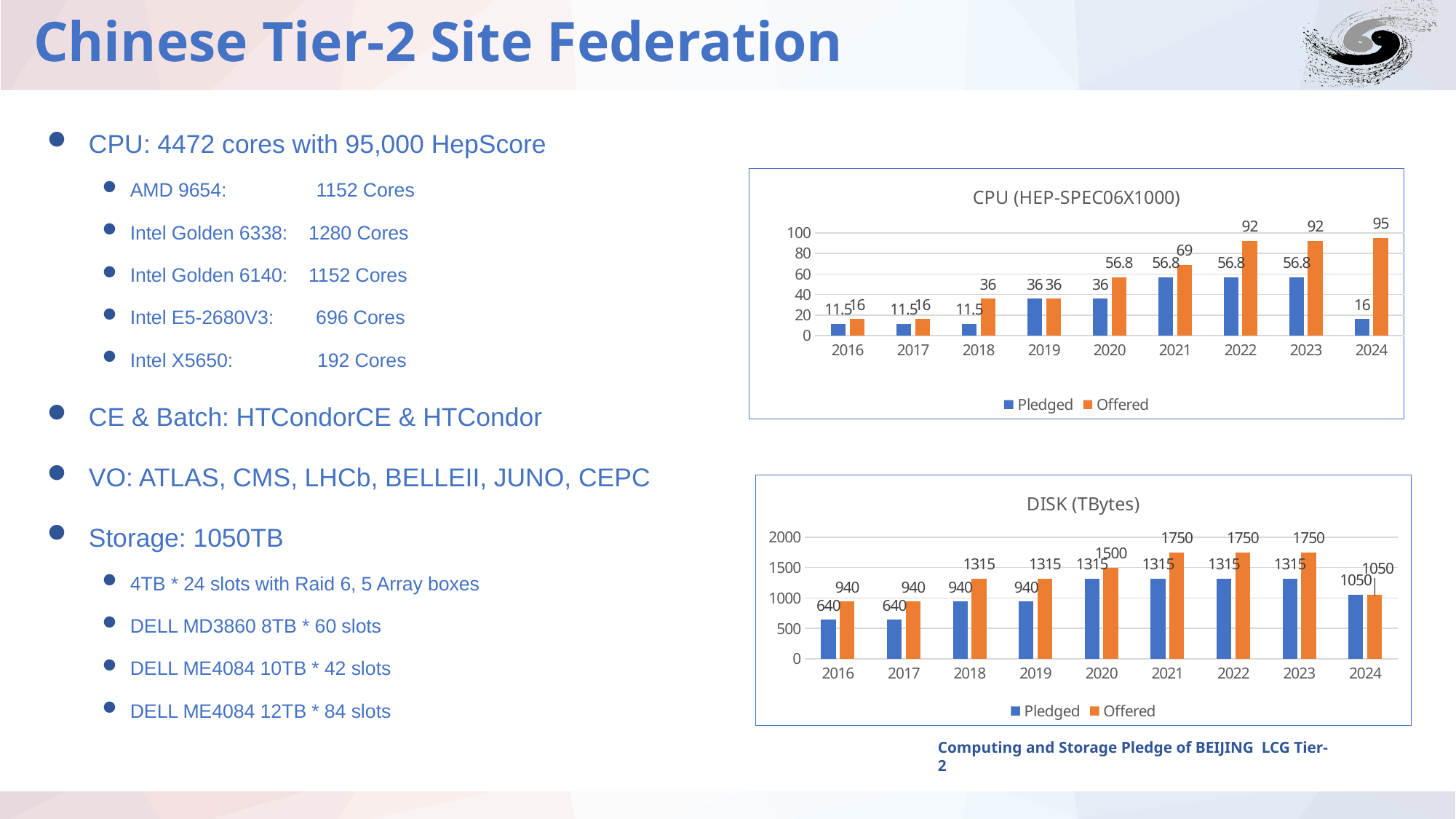
In the CPU (HEP-SPEC06X1000) chart, which year has the highest Offered value? 2024 In the DISK (TBytes) chart, what is the difference between the Offered and Pledged values for 2018? 375 In the CPU (HEP-SPEC06X1000) chart, what is the Pledged value for 2021? 56.8 In the CPU (HEP-SPEC06X1000) chart, what is the Offered value for 2024? 95 In the DISK (TBytes) chart, which year has the lowest Pledged value? 2016 and 2017 In the DISK (TBytes) chart, what is the Offered value for 2021? 1750 In the CPU (HEP-SPEC06X1000) chart, what is the difference between the Offered and Pledged values for 2022? 35.2 In the DISK (TBytes) chart, what is the Pledged value for 2016? 640 What kind of chart is the DISK (TBytes) chart? Bar chart In the DISK (TBytes) chart, is the Pledged value for 2020 larger or smaller than the Pledged value for 2024? Larger In the CPU (HEP-SPEC06X1000) chart, how many series does the legend list? 2 In the DISK (TBytes) chart, how many years are shown on the x axis? 9